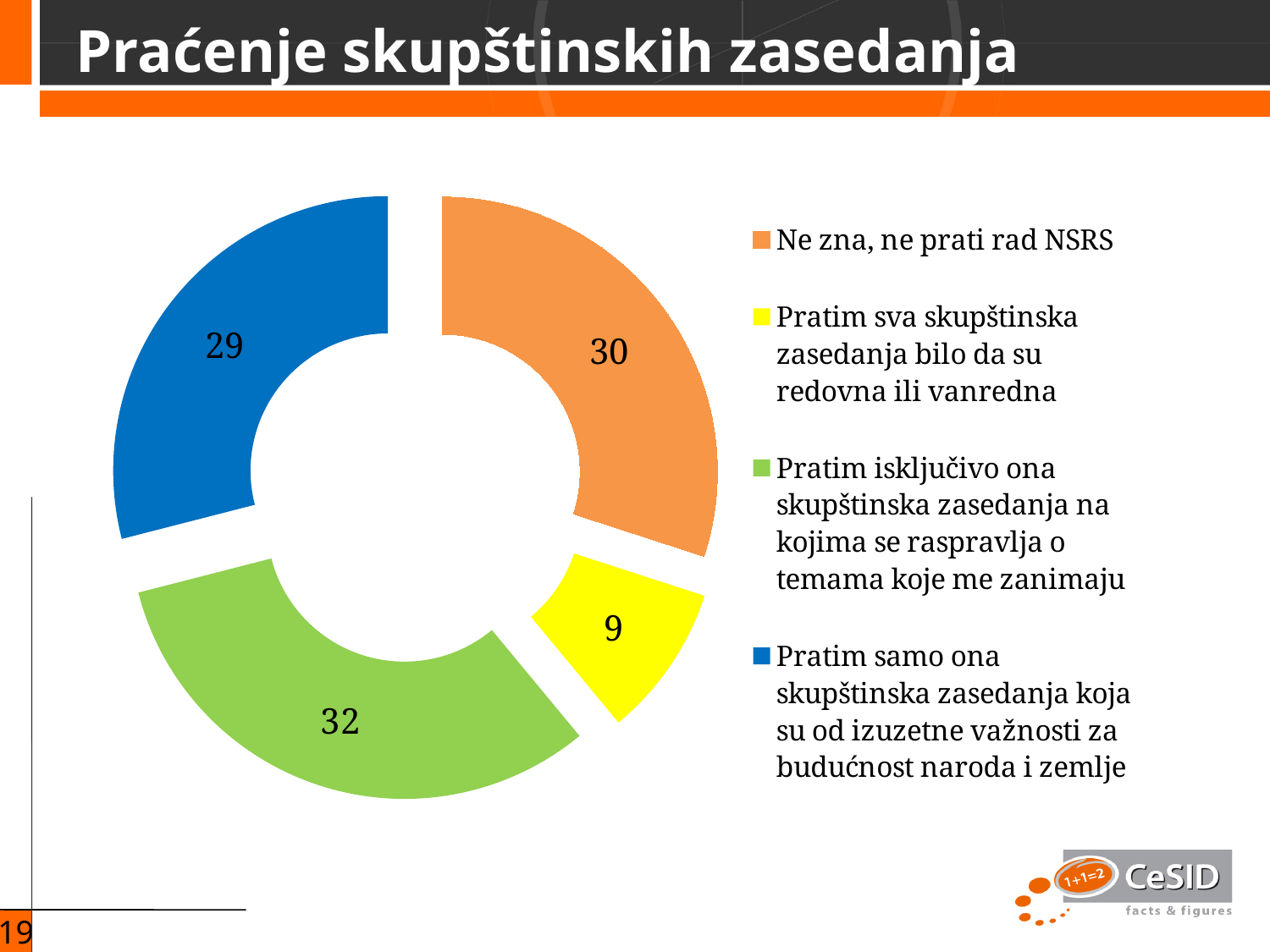
What kind of chart is shown on the slide? doughnut chart Which category has the smallest slice? Pratim sva skupštinska zasedanja bilo da su redovna ili vanredna What is the value for "Pratim sva skupštinska zasedanja bilo da su redovna ili vanredna"? 9 What is the total of all the slice values in the chart? 100 Which is larger: the value for "Ne zna, ne prati rad NSRS" or the value for "Pratim samo ona skupštinska zasedanja koja su od izuzetne važnosti za budućnost naroda i zemlje"? Ne zna, ne prati rad NSRS What colour is the slice for "Ne zna, ne prati rad NSRS"? orange What is the value for "Pratim samo ona skupštinska zasedanja koja su od izuzetne važnosti za budućnost naroda i zemlje"? 29 Which category has the largest slice? Pratim isključivo ona skupštinska zasedanja na kojima se raspravlja o temama koje me zanimaju How many categories does the chart show? 4 What is the difference between the value for "Ne zna, ne prati rad NSRS" and the value for "Pratim sva skupštinska zasedanja bilo da su redovna ili vanredna"? 21 What is the value for "Pratim isključivo ona skupštinska zasedanja na kojima se raspravlja o temama koje me zanimaju"? 32 What is the value for "Ne zna, ne prati rad NSRS"? 30